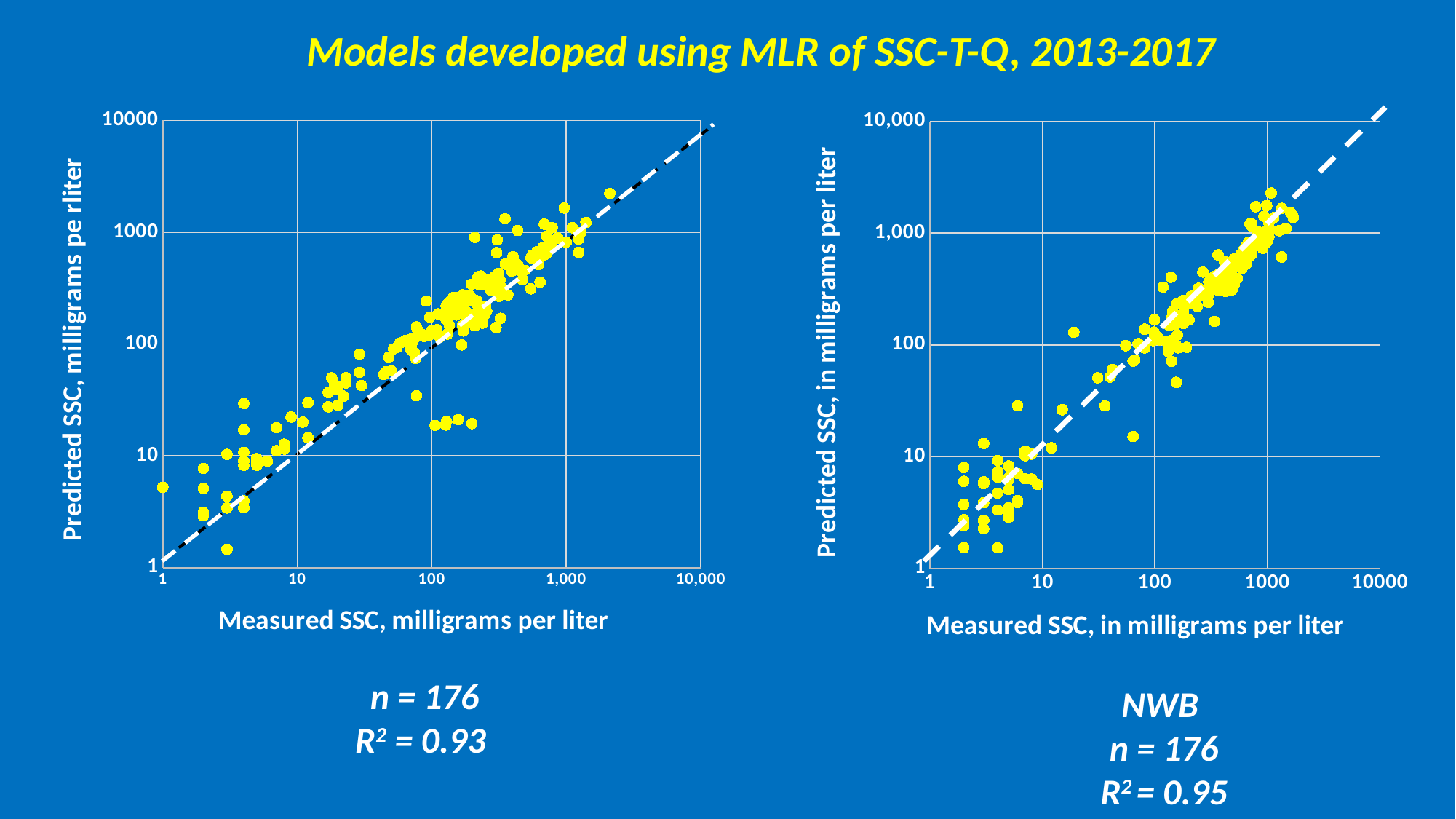
According to the text below the left chart, how many data points (n) does it contain? 176 What is the x-axis label of the right chart? Measured SSC, in milligrams per liter What R² value is given for the right chart (NWB)? 0.95 In the right chart, do the predicted SSC values generally rise or fall as measured SSC increases along the x axis? rise What is the highest tick value shown on the y axis of the right chart? 10,000 Which chart has the higher R² value, the left chart or the right chart (NWB)? the right chart (NWB) What kind of chart is the left chart on the slide? scatter plot What is the title of the slide above the two charts? Models developed using MLR of SSC-T-Q, 2013-2017 What kind of chart is the right chart on the slide? scatter plot According to the text below the right chart, how many data points (n) does it contain? 176 In the left chart, do the predicted SSC values generally rise or fall as measured SSC increases along the x axis? rise What R² value is given for the left chart? 0.93